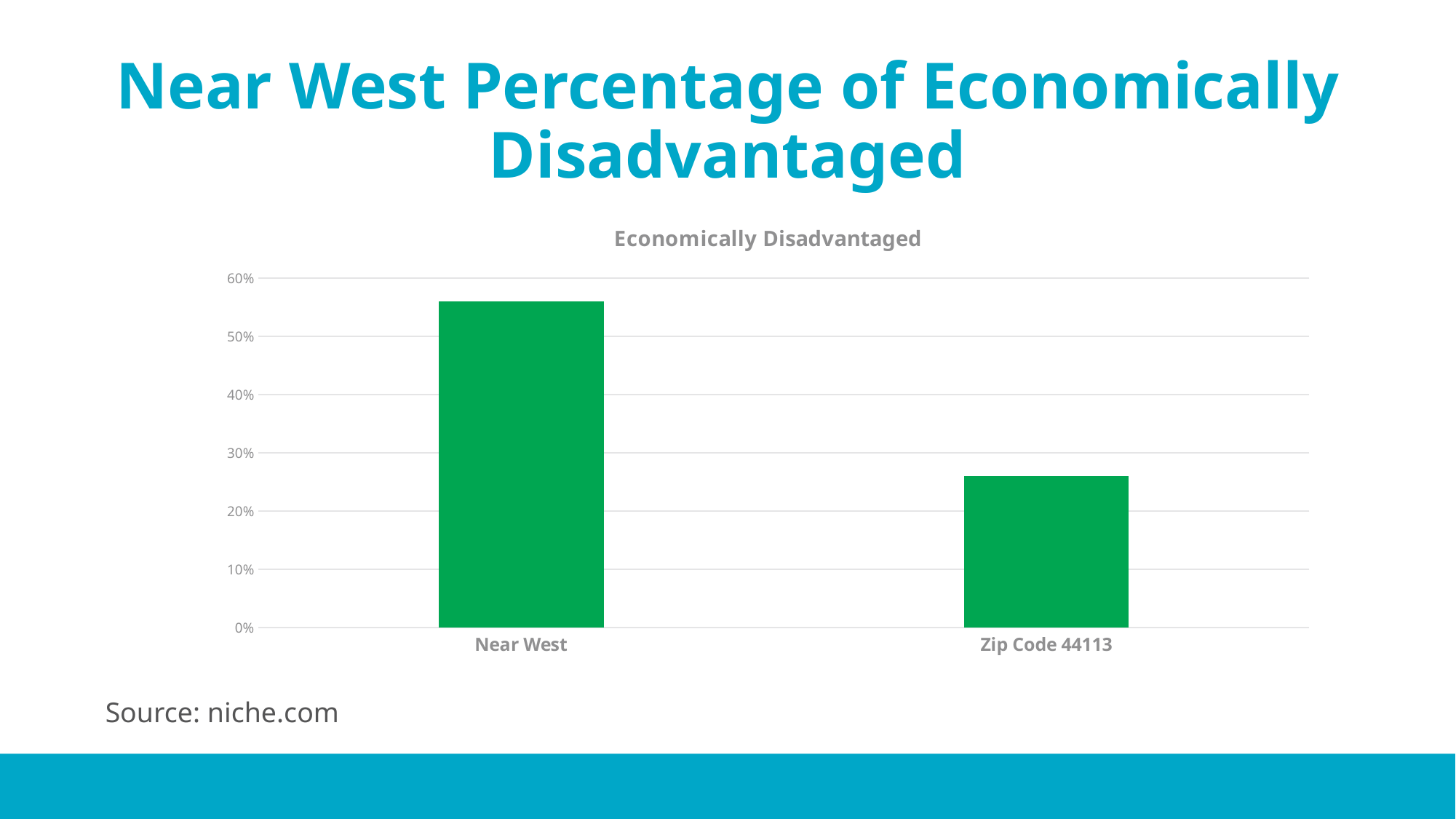
Which is larger, the value for Near West or the value for Zip Code 44113? Near West What kind of chart is shown on the slide? bar chart Is the value for Near West greater or less than 60%? less How many categories are plotted in the chart? 2 What is the title shown above the chart's plot area? Economically Disadvantaged What source is cited for the chart data? niche.com Which category has the highest value? Near West Is the value for Near West greater or less than 50%? greater Is the value for Zip Code 44113 greater or less than 20%? greater Which category has the lowest value? Zip Code 44113